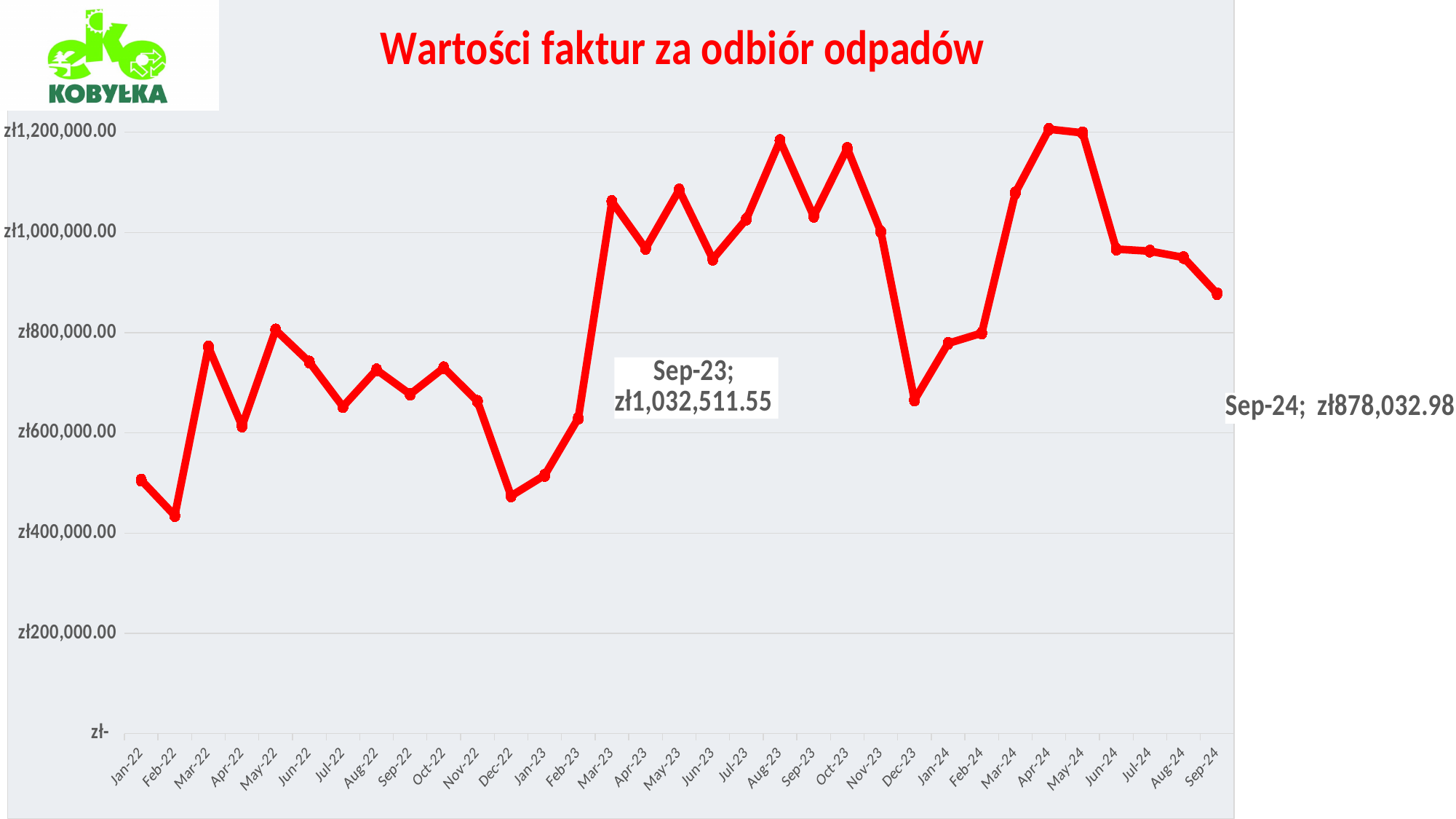
Do the values rise or fall from May-24 to Sep-24? fall What is the difference between the values for Sep-23 and Sep-24? zł154,478.57 What is the value for Sep-23? zł1,032,511.55 Which month has the lowest value on the chart? Feb-22 What kind of chart is shown on the slide? line chart How many monthly data points are plotted on the chart? 33 Is the value for Aug-23 greater or less than 1,000,000? greater What is the title of the chart? Wartości faktur za odbiór odpadów Is the value for Feb-22 greater or less than 600,000? less What is the value for Sep-24? zł878,032.98 Is the value for Dec-23 greater or less than 800,000? less Which is larger, the value for Mar-23 or the value for Dec-23? Mar-23